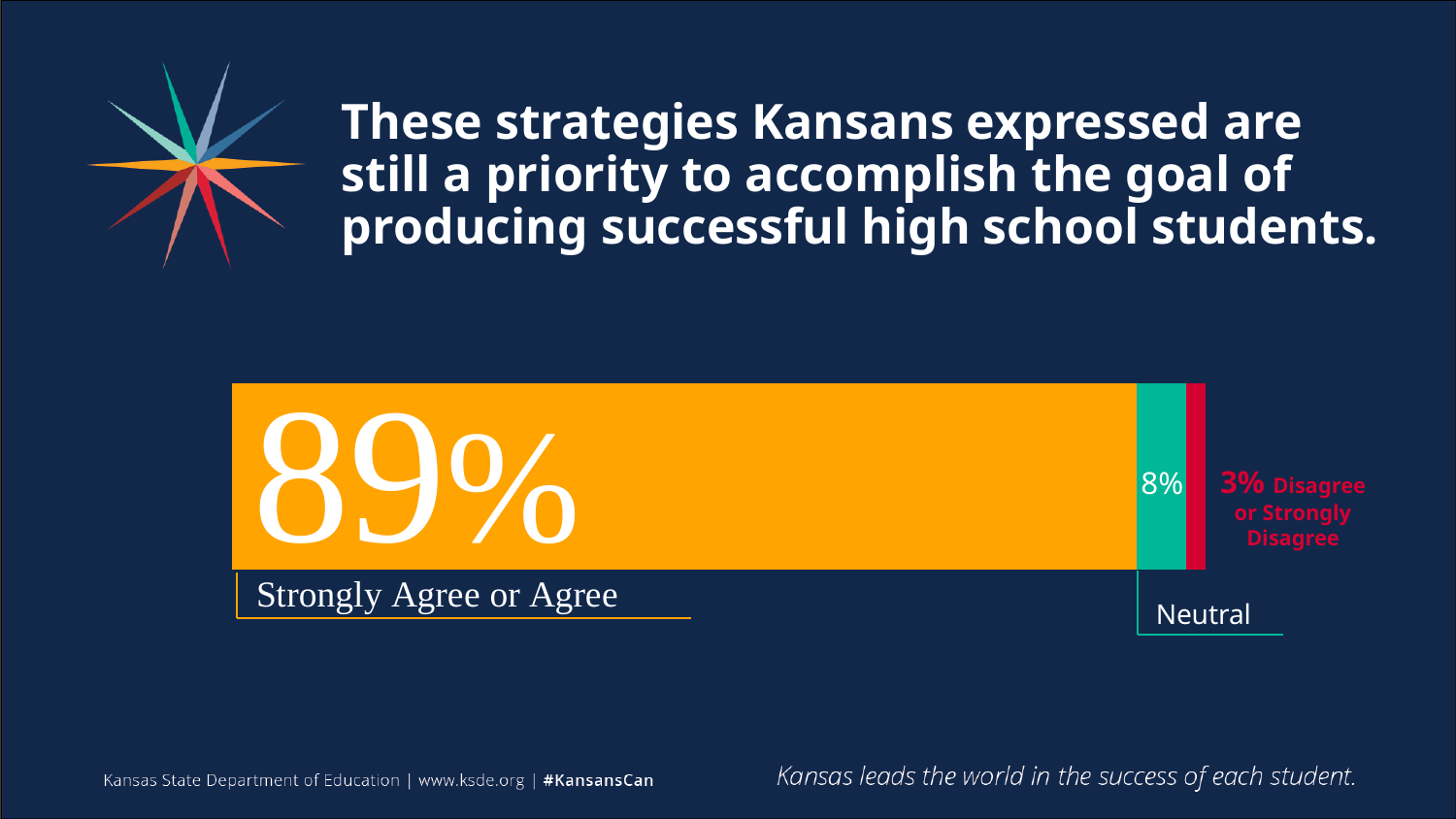
What percentage of respondents said they Strongly Agree or Agree? 89% What is the difference in percentage points between Neutral and Disagree or Strongly Disagree? 5 What colour is the Strongly Agree or Agree segment of the bar? Orange What is the total of the three segments in the stacked bar? 100% What kind of chart is shown on the slide? Bar chart Which response category has the smallest share? Disagree or Strongly Disagree How many response categories are shown in the bar? 3 What is the difference in percentage points between Strongly Agree or Agree and Neutral? 81 Which response category has the largest share? Strongly Agree or Agree What percentage of respondents said they Disagree or Strongly Disagree? 3% What percentage of respondents were Neutral? 8% Which is larger, the Neutral share or the Disagree or Strongly Disagree share? Neutral